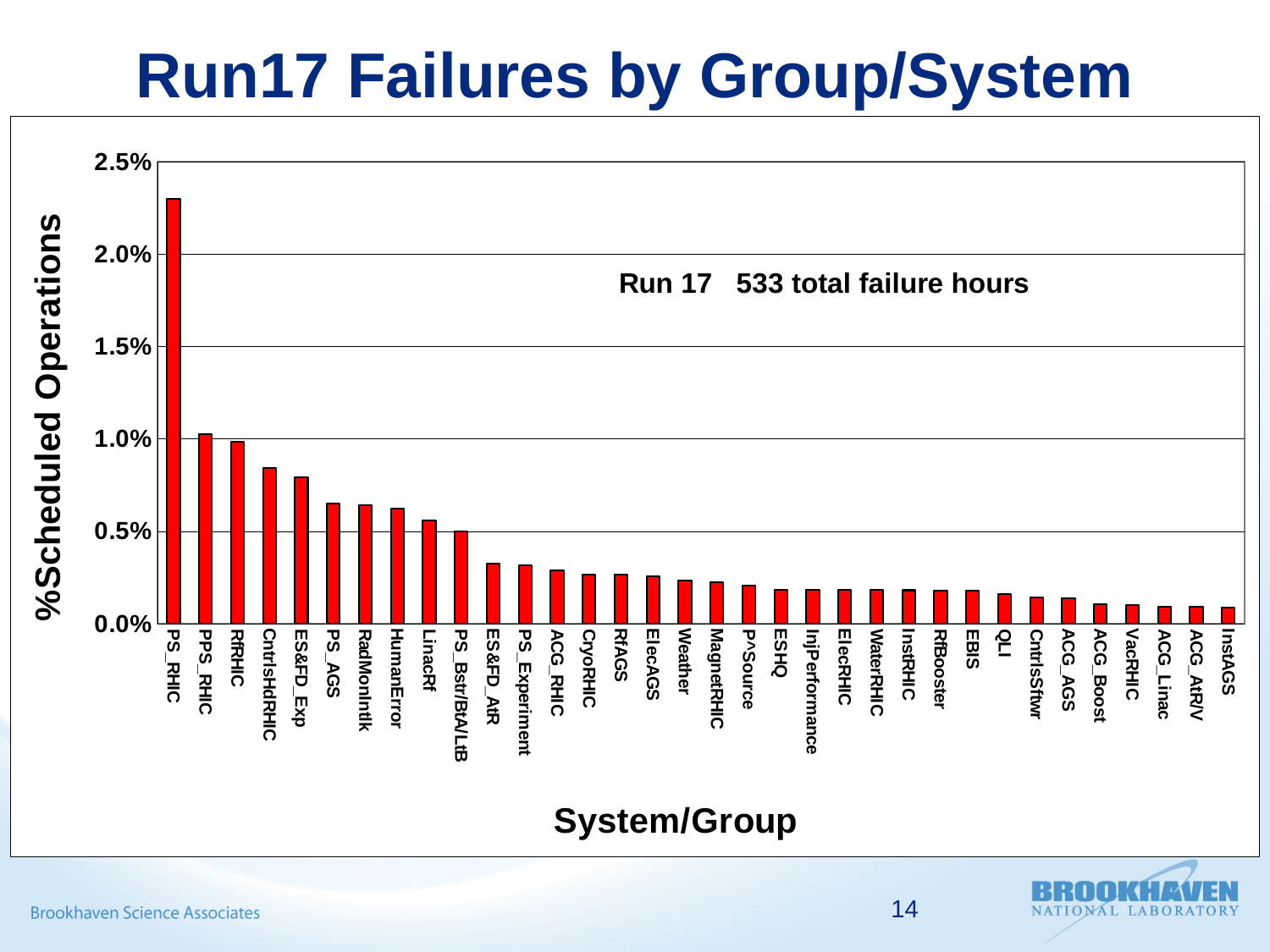
Is the value for PS_RHIC greater or less than 2.0%? greater Is the value for CntrlsHdRHIC greater or less than 1.0%? less What kind of chart is shown on the slide? bar chart Is the value for ES&FD_AtR greater or less than 0.5%? less What is the label of the y axis? %Scheduled Operations Which has a larger value, EBIS or LinacRf? LinacRf According to the text inside the chart, how many total failure hours were there in Run 17? 533 Do the bar values rise or fall moving from left to right along the x axis? fall How many systems/groups are plotted on the x axis? 34 Which has a larger value, PPS_RHIC or HumanError? PPS_RHIC Which system/group has the highest percentage of scheduled operations lost to failures? PS_RHIC